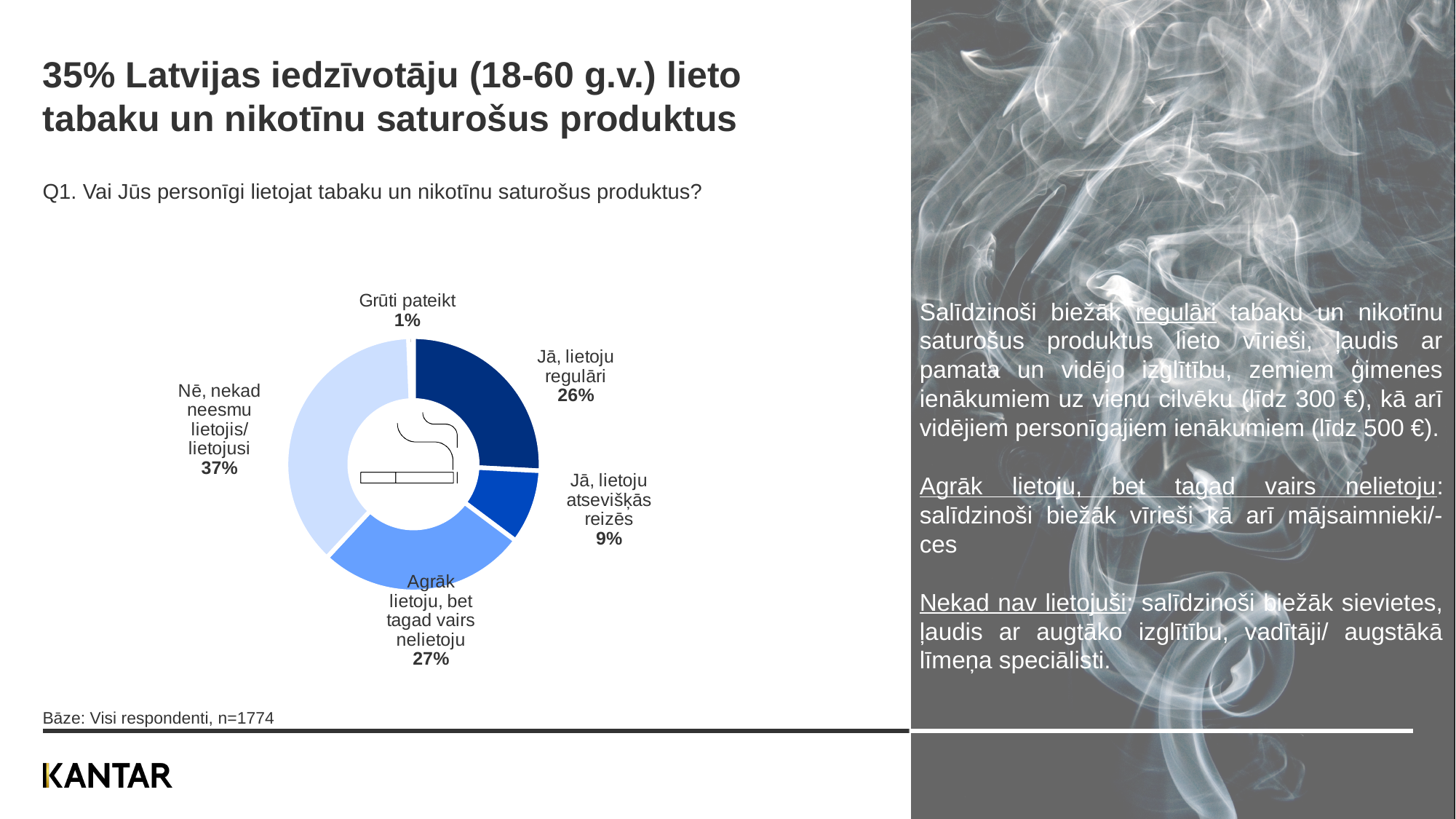
How many response categories are shown in the chart? 5 Which is larger: the share for "Agrāk lietoju, bet tagad vairs nelietoju" or for "Jā, lietoju regulāri"? Agrāk lietoju, bet tagad vairs nelietoju What is the base (number of respondents) stated for the chart? n=1774 What share of respondents answered "Nē, nekad neesmu lietojis/ lietojusi"? 37% What share of respondents answered "Jā, lietoju regulāri"? 26% Which response category has the smallest share in the chart? Grūti pateikt What type of chart is shown on the slide? Pie chart (doughnut) What share of respondents answered "Jā, lietoju atsevišķās reizēs"? 9% Which response category has the largest share in the chart? Nē, nekad neesmu lietojis/ lietojusi What share of respondents answered "Agrāk lietoju, bet tagad vairs nelietoju"? 27% What share of respondents answered "Grūti pateikt"? 1% What is the difference in percentage points between "Jā, lietoju regulāri" and "Jā, lietoju atsevišķās reizēs"? 17 percentage points